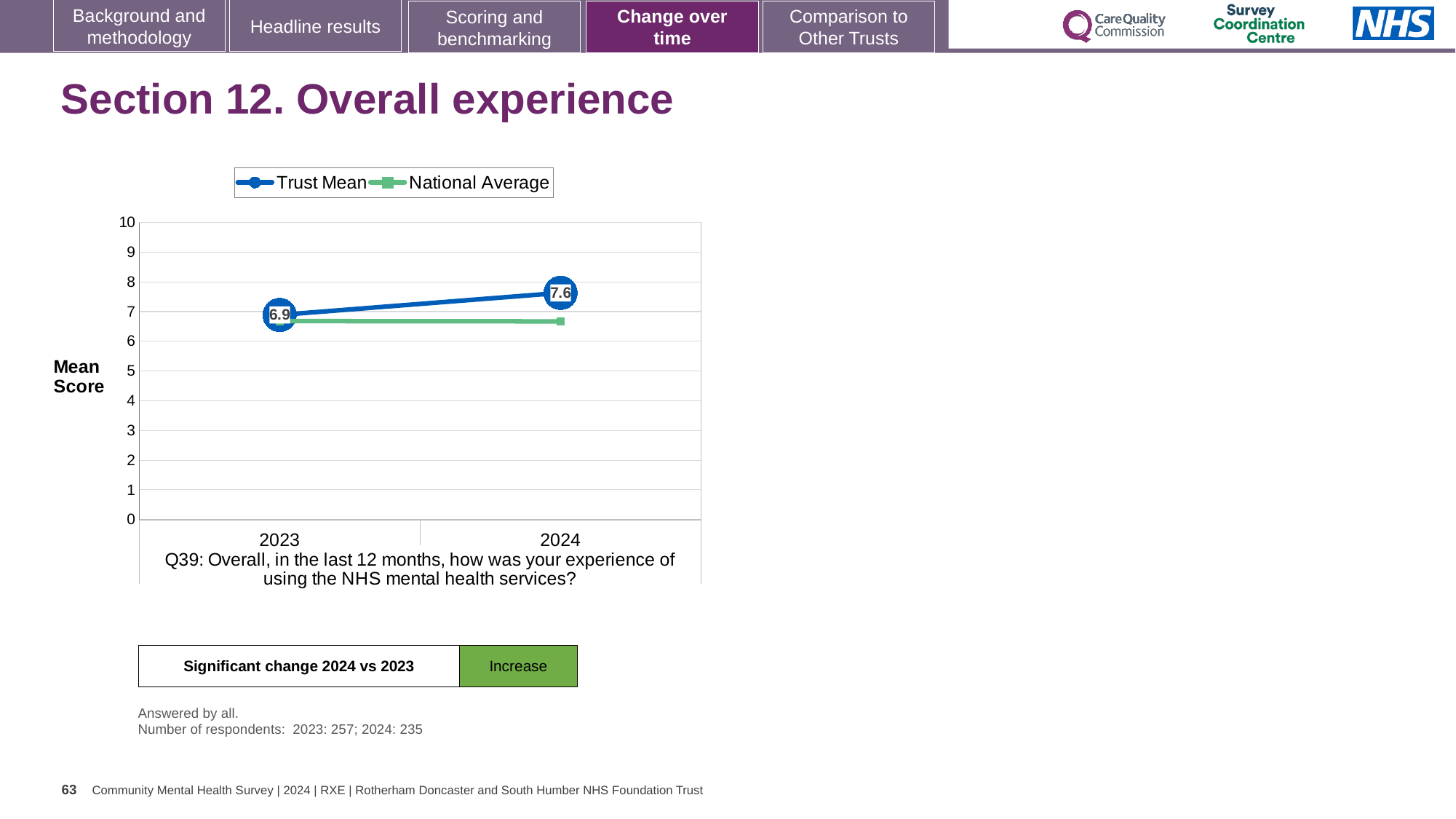
Which year has the higher Trust Mean, 2023 or 2024? 2024 Is the National Average value for 2024 greater or less than 7? less What kind of chart is shown on the slide? line chart What is the Trust Mean value for 2023? 6.9 In 2024, which series has the higher value, Trust Mean or National Average? Trust Mean By how much did the Trust Mean change from 2023 to 2024? 0.7 How many series does the chart legend list? 2 What are the two series named in the chart legend? Trust Mean and National Average Does the Trust Mean rise or fall from 2023 to 2024? rises Is the National Average value for 2023 greater or less than 6? greater What is the Trust Mean value for 2024? 7.6 How many years are shown on the x axis of the chart? 2